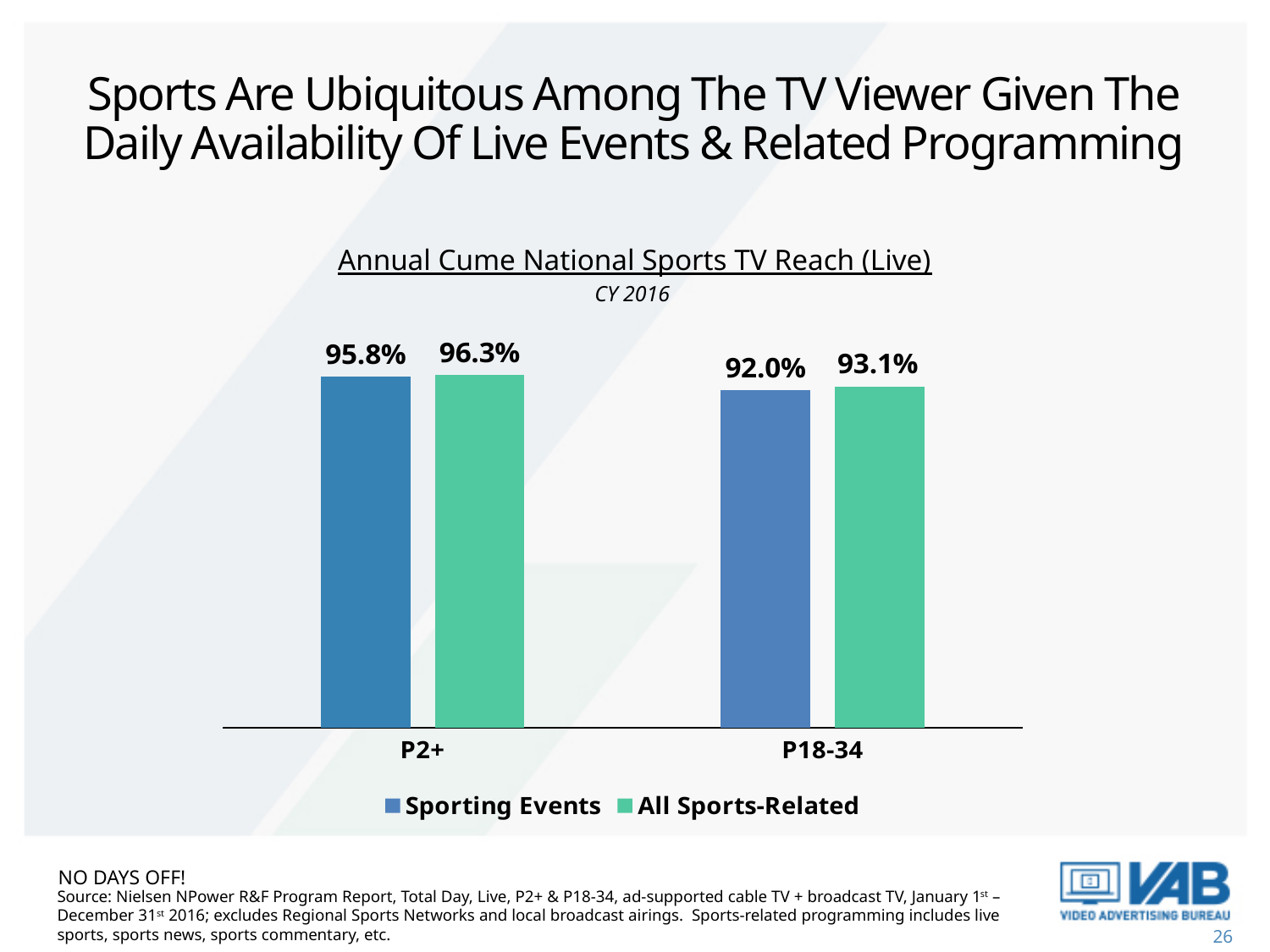
How many series does the legend list? 2 Which is larger for P2+: Sporting Events reach or All Sports-Related reach? All Sports-Related Which category has the lowest Sporting Events reach? P18-34 What is the All Sports-Related reach for P2+? 96.3% What is the All Sports-Related reach for P18-34? 93.1% What is the difference between the All Sports-Related and Sporting Events reach for P18-34? 1.1% What is the difference between the Sporting Events reach for P2+ and for P18-34? 3.8% How many categories are shown on the x axis? 2 What is the Sporting Events reach for P2+? 95.8% What is the Sporting Events reach for P18-34? 92.0% Which category has the highest All Sports-Related reach? P2+ What kind of chart is shown on the slide? Bar chart